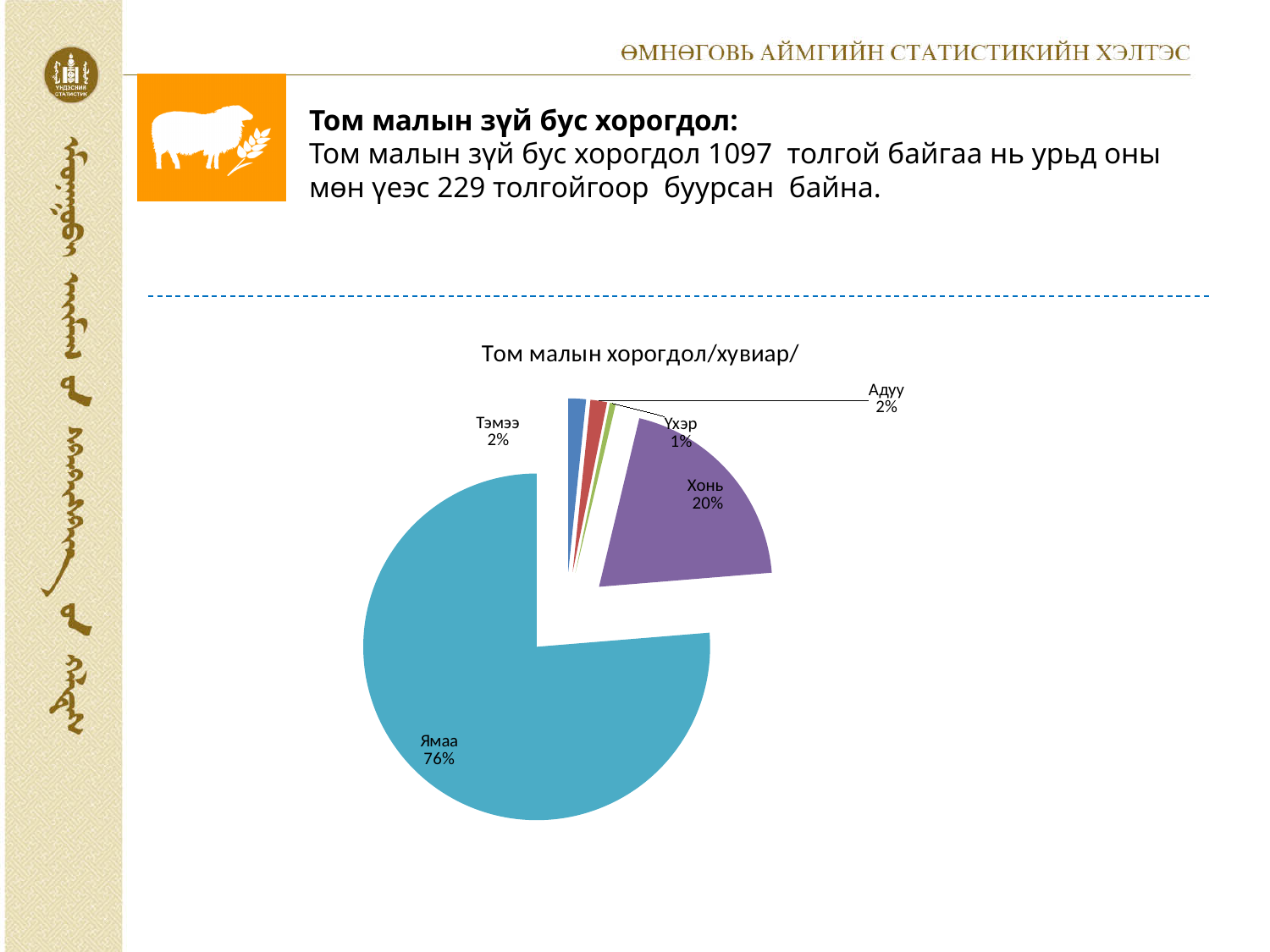
What is the difference in percentage points between the Ямаа share and the Хонь share? 56 percentage points How many categories are shown in the pie chart? 5 What share of the pie does Тэмээ account for? 2% What share of the pie does Үхэр account for? 1% What kind of chart is shown on the slide? pie chart Which category has the largest slice of the pie? Ямаа What share of the pie does Ямаа account for? 76% Which is larger, the share for Хонь or the share for Тэмээ? Хонь What is the title of the chart? Том малын хорогдол/хувиар/ Which category has the smallest slice of the pie? Үхэр